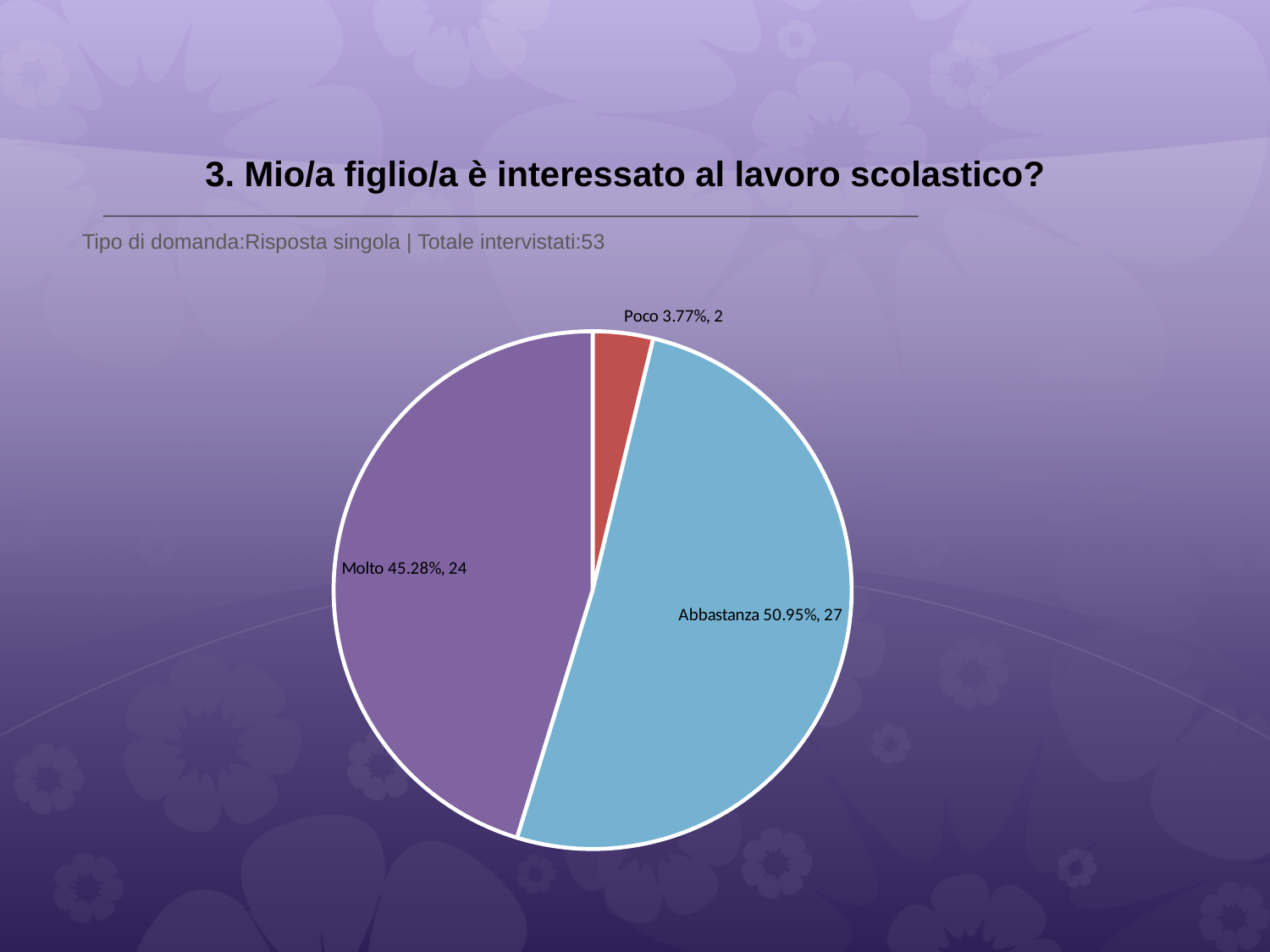
Which response has the largest slice of the pie? Abbastanza How many slices does the pie chart have? 3 How many respondents answered 'Molto'? 24 What percentage share does the 'Abbastanza' slice have? 50.95% What is the difference in number of respondents between 'Abbastanza' and 'Molto'? 3 What percentage share does the 'Poco' slice have? 3.77% How many respondents answered 'Poco'? 2 What is the title of the chart on the slide? 3. Mio/a figlio/a è interessato al lavoro scolastico? How many respondents answered 'Abbastanza'? 27 Which response has the smallest slice of the pie? Poco What kind of chart is shown on the slide? pie chart What percentage share does the 'Molto' slice have? 45.28%